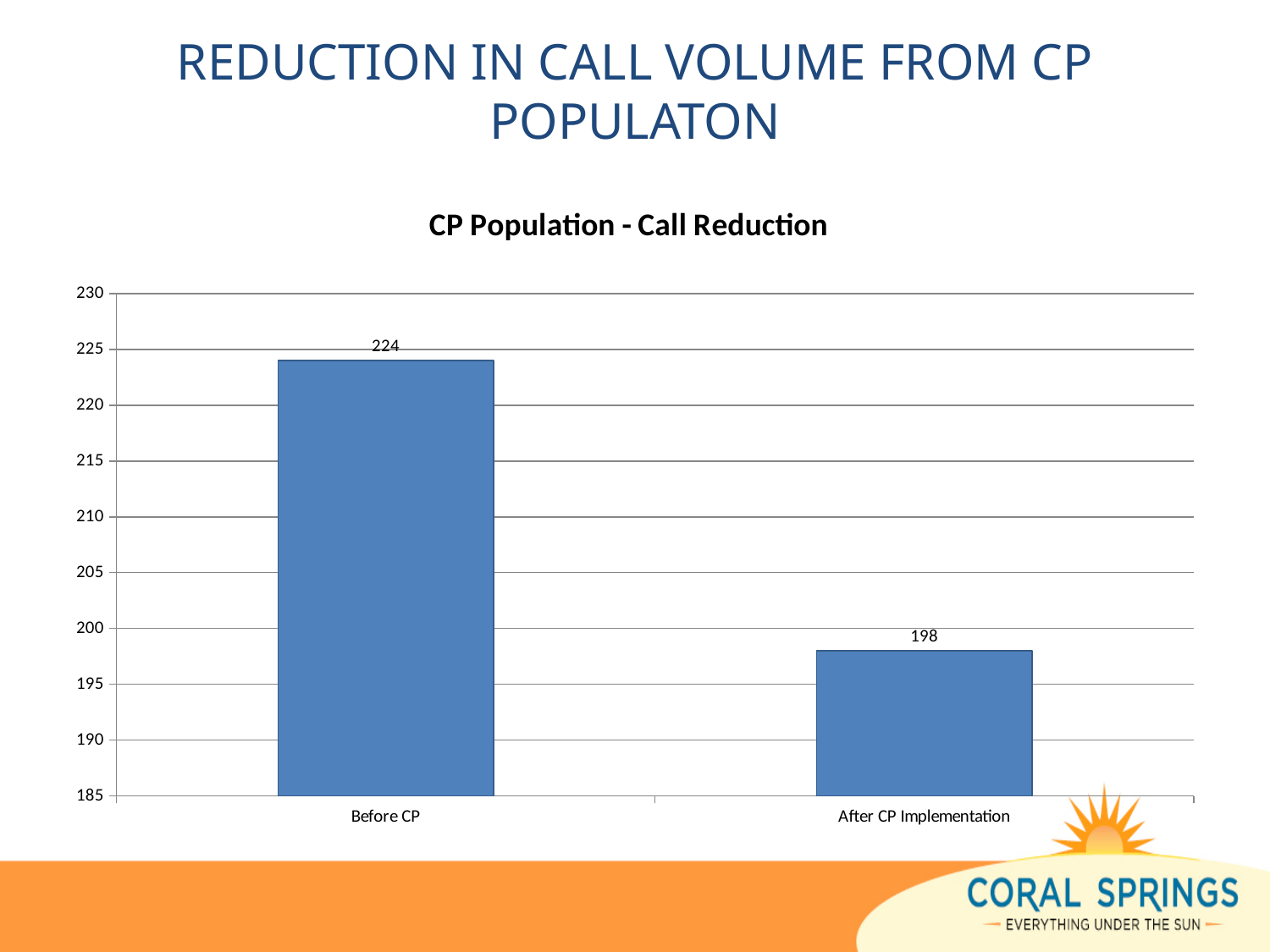
Which category has the highest value? Before CP What is the value for After CP Implementation? 198 Is the value for Before CP greater or less than 220? greater Is the value for After CP Implementation greater or less than 200? less What is the difference between the Before CP and After CP Implementation values? 26 How many categories are shown on the x axis? 2 Do the values rise or fall from Before CP to After CP Implementation? fall What kind of chart is shown? bar chart What is the value for Before CP? 224 Which is larger, the value for Before CP or the value for After CP Implementation? Before CP What is the title of the chart? CP Population - Call Reduction Which category has the lowest value? After CP Implementation